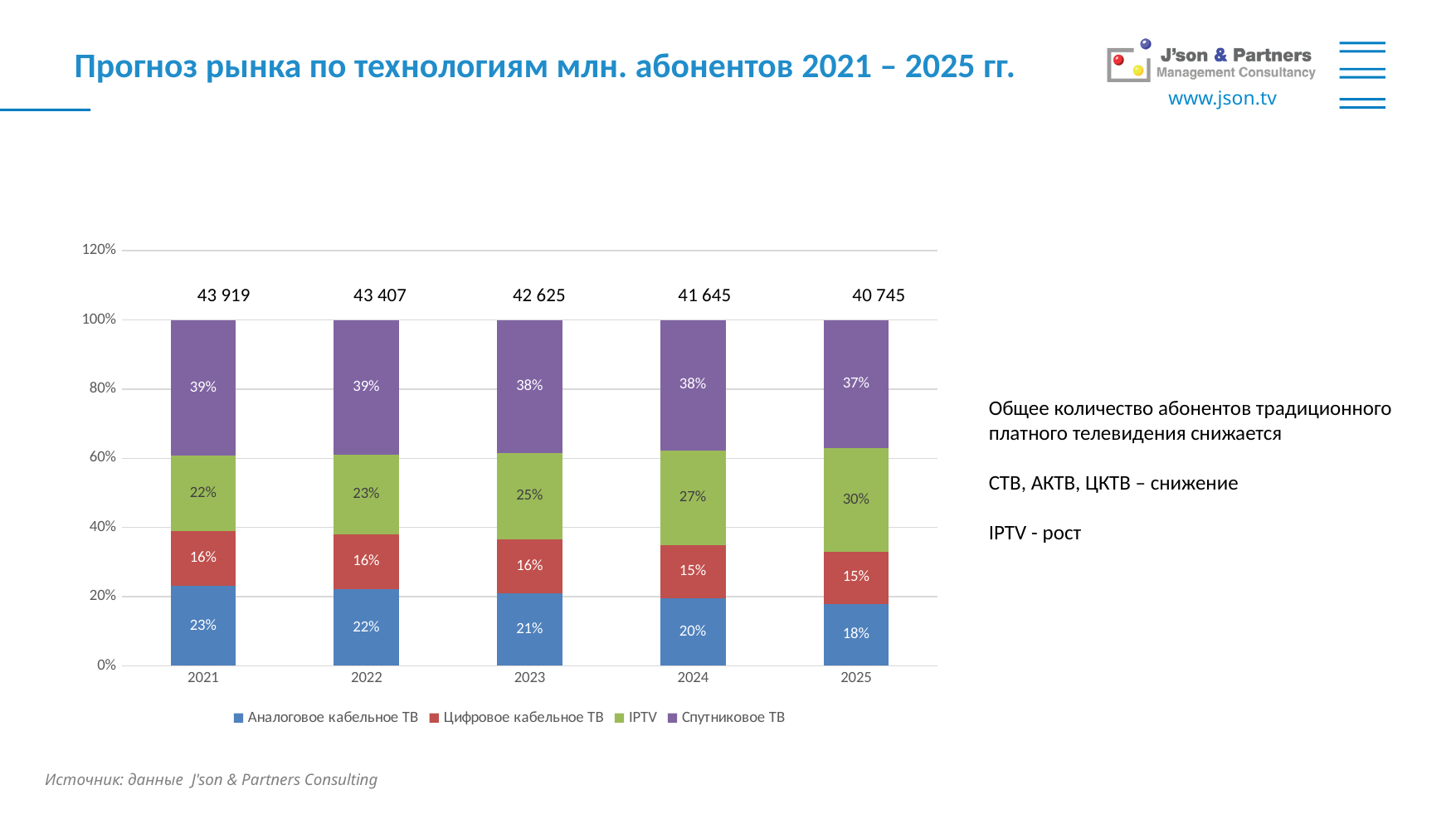
Does the share of Аналоговое кабельное ТВ rise or fall from 2021 to 2025? Fall How many series does the legend list? 4 Which year has the lowest total printed above its bar? 2025 Which is larger in 2023: the share of Спутниковое ТВ or the share of IPTV? Спутниковое ТВ What total number of subscribers is printed above the 2023 bar? 42 625 What share does IPTV have in 2025? 30% What is the share of Аналоговое кабельное ТВ in 2021? 23% What kind of chart is shown on the slide? Stacked bar chart What share does Спутниковое ТВ have in 2024? 38% By how many percentage points does the IPTV share in 2025 exceed its share in 2021? 8 percentage points How many years are shown on the x axis? 5 Which year has the highest total printed above its bar? 2021